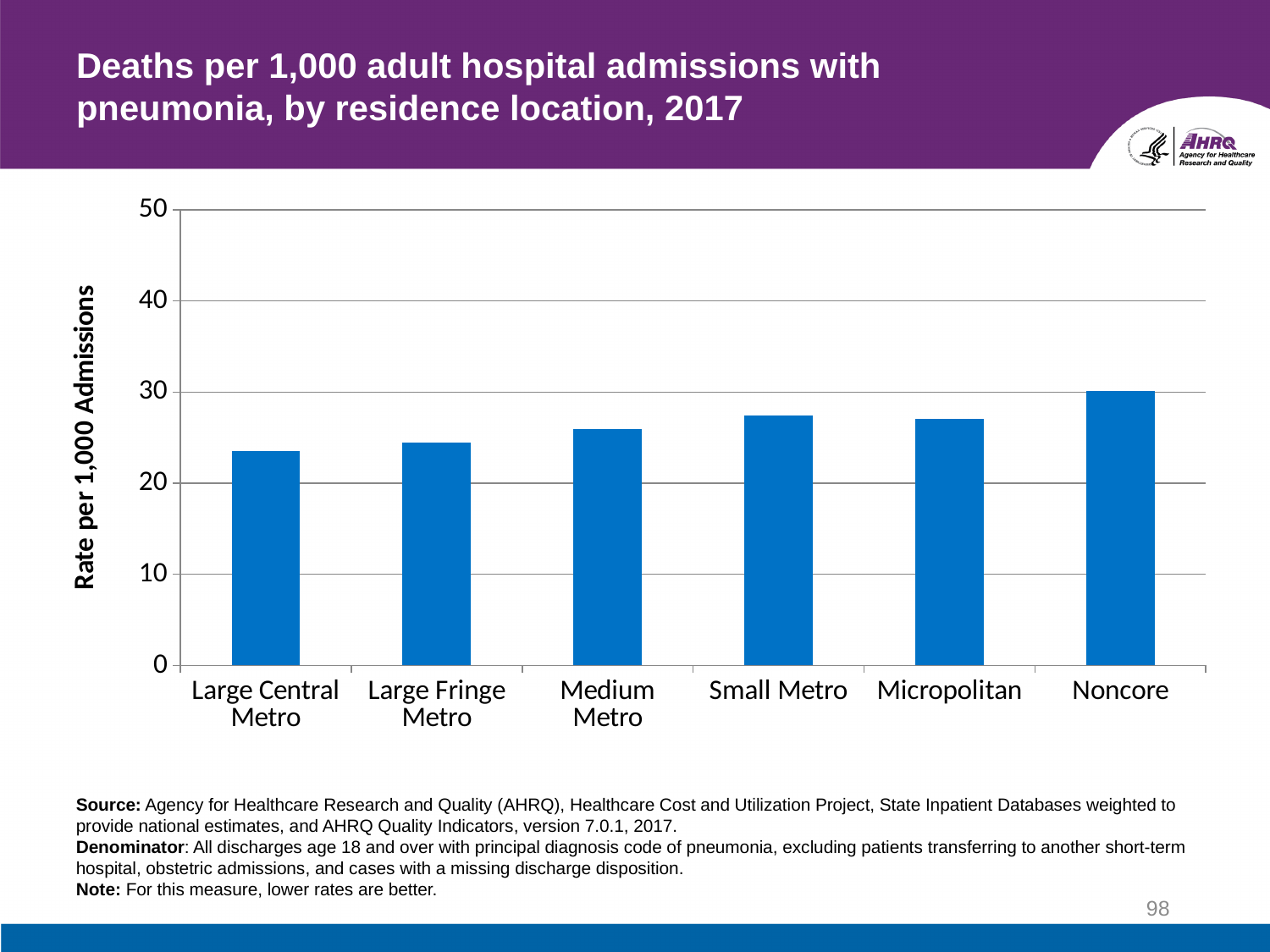
Is the value for Small Metro greater or less than 20? greater Which residence location has the highest death rate per 1,000 admissions? Noncore What is the highest value shown on the y axis? 50 Which residence location has the lowest death rate per 1,000 admissions? Large Central Metro Which has a higher death rate, Noncore or Large Central Metro? Noncore What kind of chart is shown on the slide? bar chart What is the label on the y axis of the chart? Rate per 1,000 Admissions Which has a higher death rate, Medium Metro or Large Fringe Metro? Medium Metro Is the value for Medium Metro greater or less than 30? less How many residence location categories are shown on the x axis? 6 Is the value for Large Central Metro greater or less than 30? less